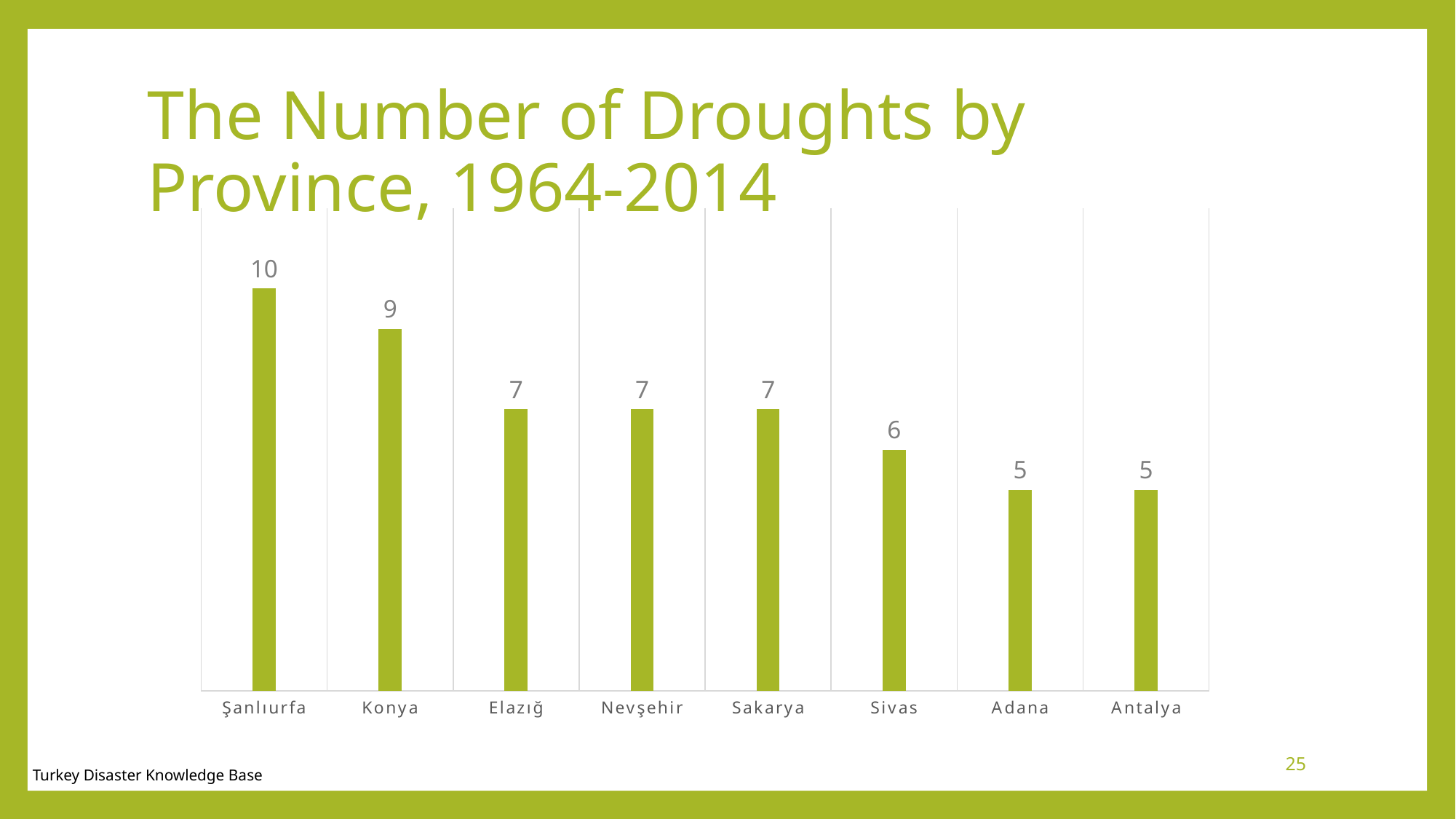
What is the difference between the number of droughts in Şanlıurfa and Antalya? 5 What is the number of droughts for Konya? 9 What is the difference between the values for Konya and Sivas? 3 Do the values rise or fall from left to right across the provinces? Fall Which province has the highest number of droughts? Şanlıurfa How many droughts are shown for Şanlıurfa? 10 What is the value shown for Sivas? 6 What is the title of the chart on the slide? The Number of Droughts by Province, 1964-2014 How many provinces are shown in the chart? 8 Which has more droughts, Sivas or Adana? Sivas What kind of chart is shown on the slide? Bar chart Which has more droughts, Konya or Elazığ? Konya